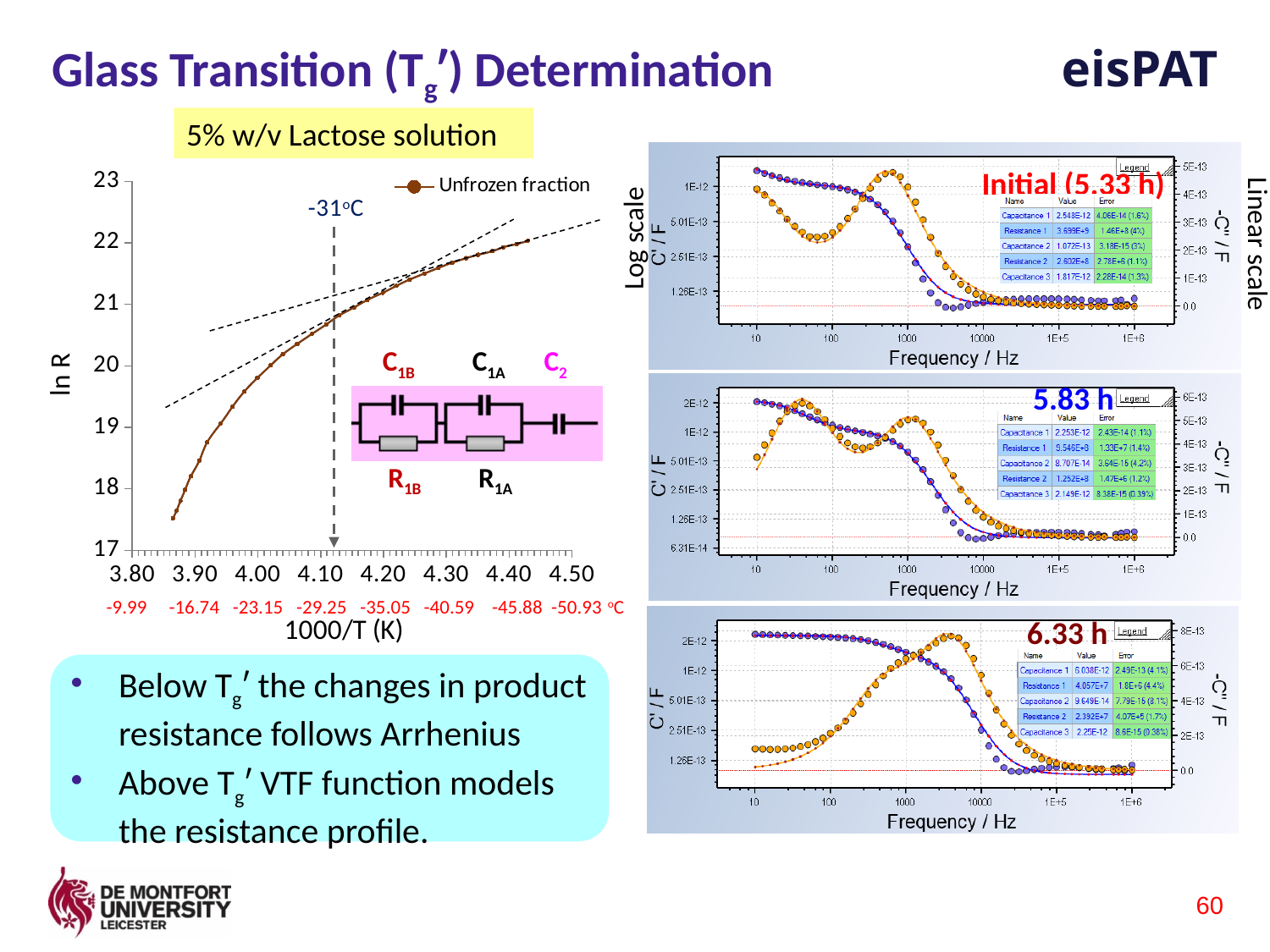
In the ln R chart on the left, is the value of ln R at 1000/T = 4.10 greater or less than 20? greater What is the name of the series shown in the legend of the ln R chart on the left? Unfrozen fraction In the ln R chart on the left, is the value of ln R at 1000/T = 4.00 greater or less than 21? less How many series does the legend of the ln R chart on the left list? 1 In the ln R chart on the left, is the value of ln R at 1000/T = 4.40 greater or less than 21? greater What kind of chart is the ln R versus 1000/T chart on the left of the slide? line chart What temperature is marked by the dashed vertical line in the ln R chart on the left? -31°C How many frequency-response charts are shown on the right side of the slide? 3 In the ln R chart on the left, does ln R rise or fall as 1000/T increases from 3.80 to 4.50? rise